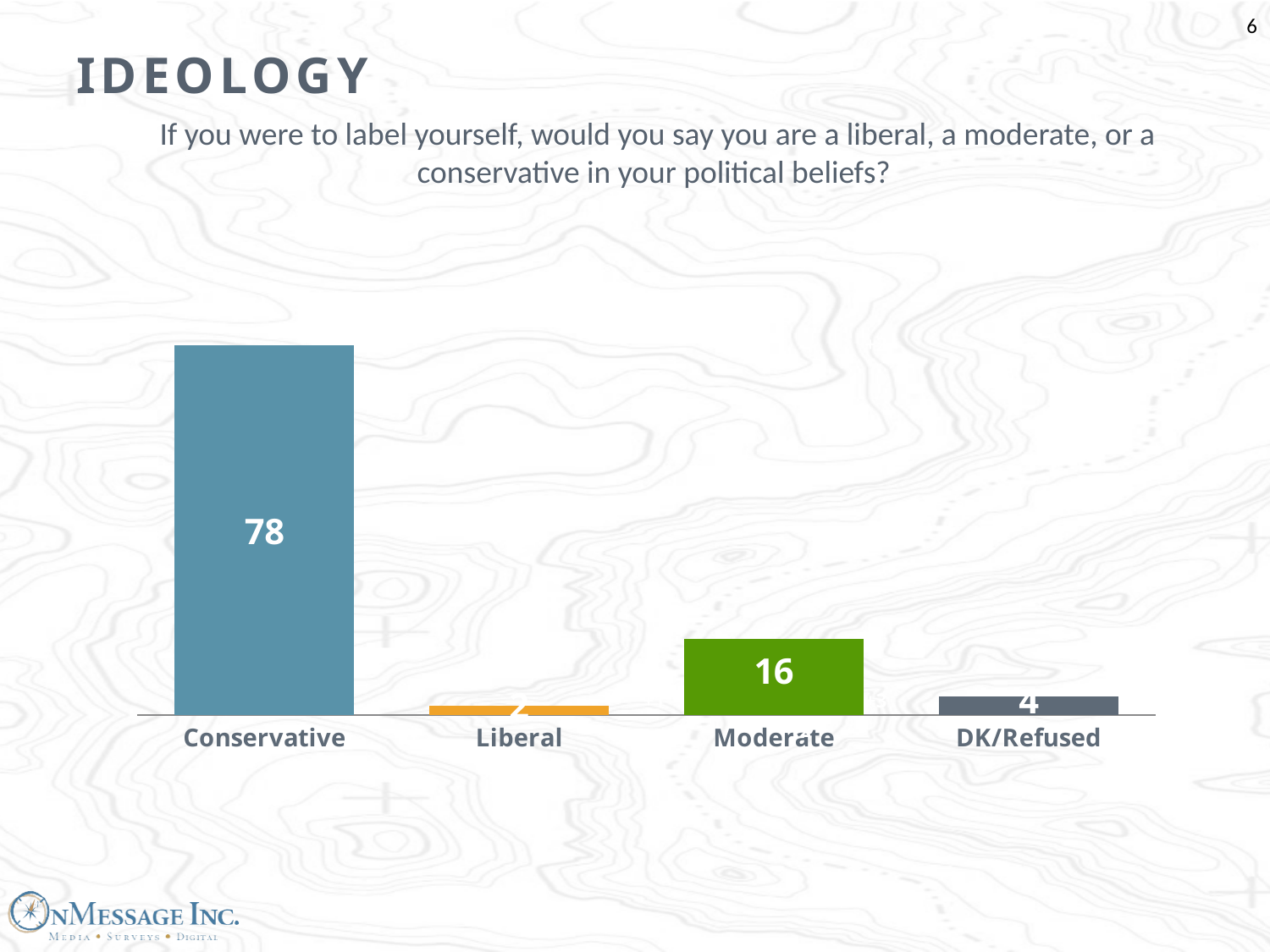
What is the difference between the Conservative and Moderate values? 62 How many categories are shown in the chart? 4 What kind of chart is shown on the slide? Bar chart What is the value for DK/Refused? 4 Which is larger, the value for Conservative or the value for Moderate? Conservative What is the value for Moderate? 16 Which is larger, the value for Moderate or the value for DK/Refused? Moderate Which category has the lowest value? Liberal What is the title of the slide containing the chart? IDEOLOGY Which category has the highest value? Conservative What is the difference between the Moderate and DK/Refused values? 12 What is the value for Conservative? 78